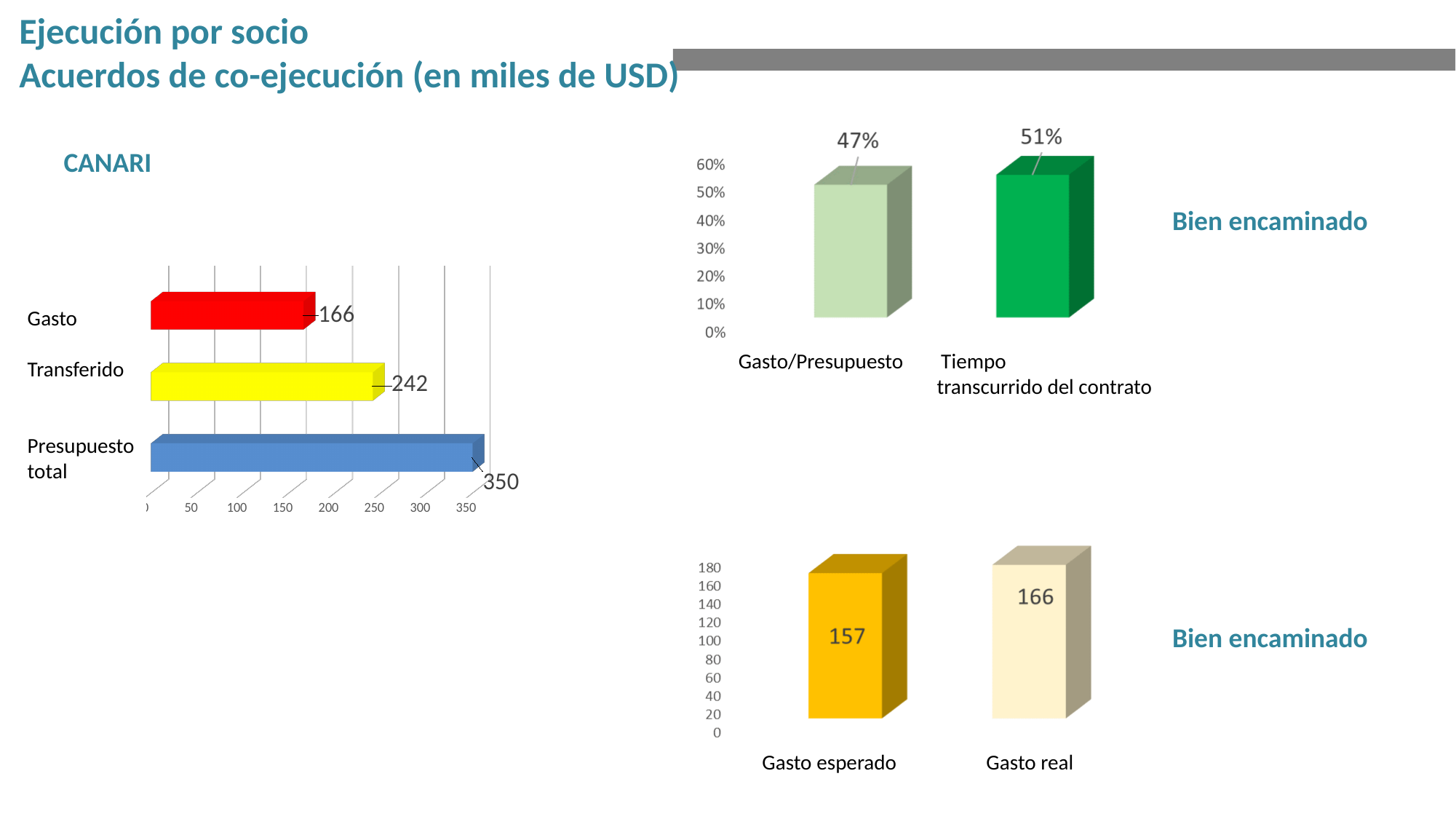
In the CANARI bar chart on the left, what is the value for Presupuesto total? 350 In the CANARI bar chart on the left, what is the difference between Presupuesto total and Transferido? 108 In the CANARI bar chart on the left, what is the value for Transferido? 242 In the CANARI bar chart on the left, which category has the lowest value? Gasto In the bottom-right chart, what is the value for Gasto esperado? 157 What kind of chart is the CANARI chart on the left? Bar chart In the CANARI bar chart on the left, what is the value for Gasto? 166 In the top-right chart, what is the value for Tiempo transcurrido del contrato? 51% In the bottom-right chart, what is the difference between Gasto real and Gasto esperado? 9 In the CANARI bar chart on the left, how many categories are shown? 3 In the top-right chart, what is the value for Gasto/Presupuesto? 47% In the bottom-right chart, which is larger, Gasto esperado or Gasto real? Gasto real